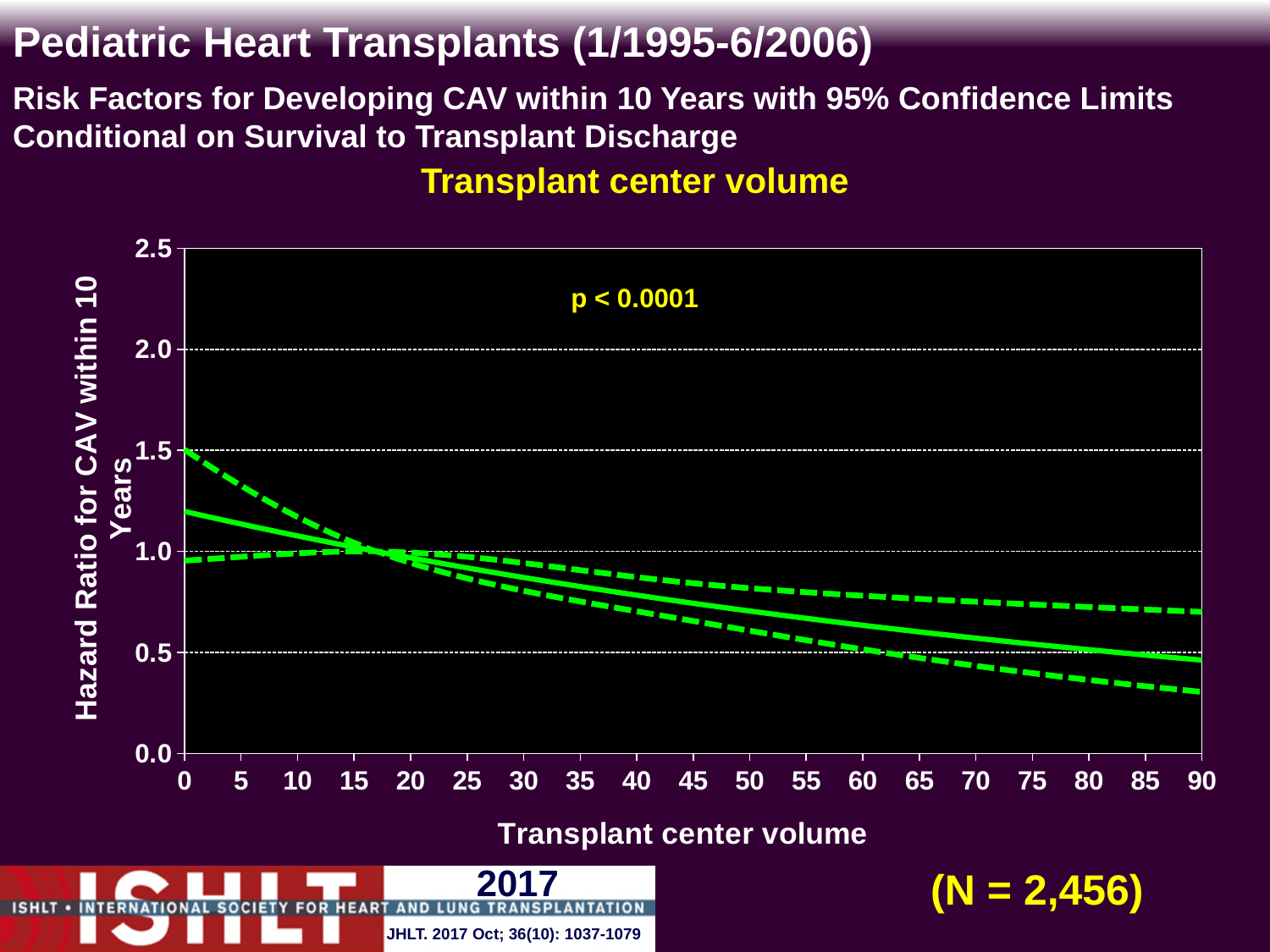
Is the hazard ratio on the solid line at a transplant center volume of 0 greater or less than 1.0? greater What p-value is printed on the chart? p < 0.0001 Is the hazard ratio on the solid line at a transplant center volume of 45 greater or less than 1.0? less Does the solid hazard ratio line rise or fall as transplant center volume increases along the x axis? fall What kind of chart is shown on the slide? line chart Is the hazard ratio on the solid line at a transplant center volume of 45 greater or less than 0.5? greater How many lines are plotted on the chart? 3 What is the highest value shown on the y axis of the chart? 2.5